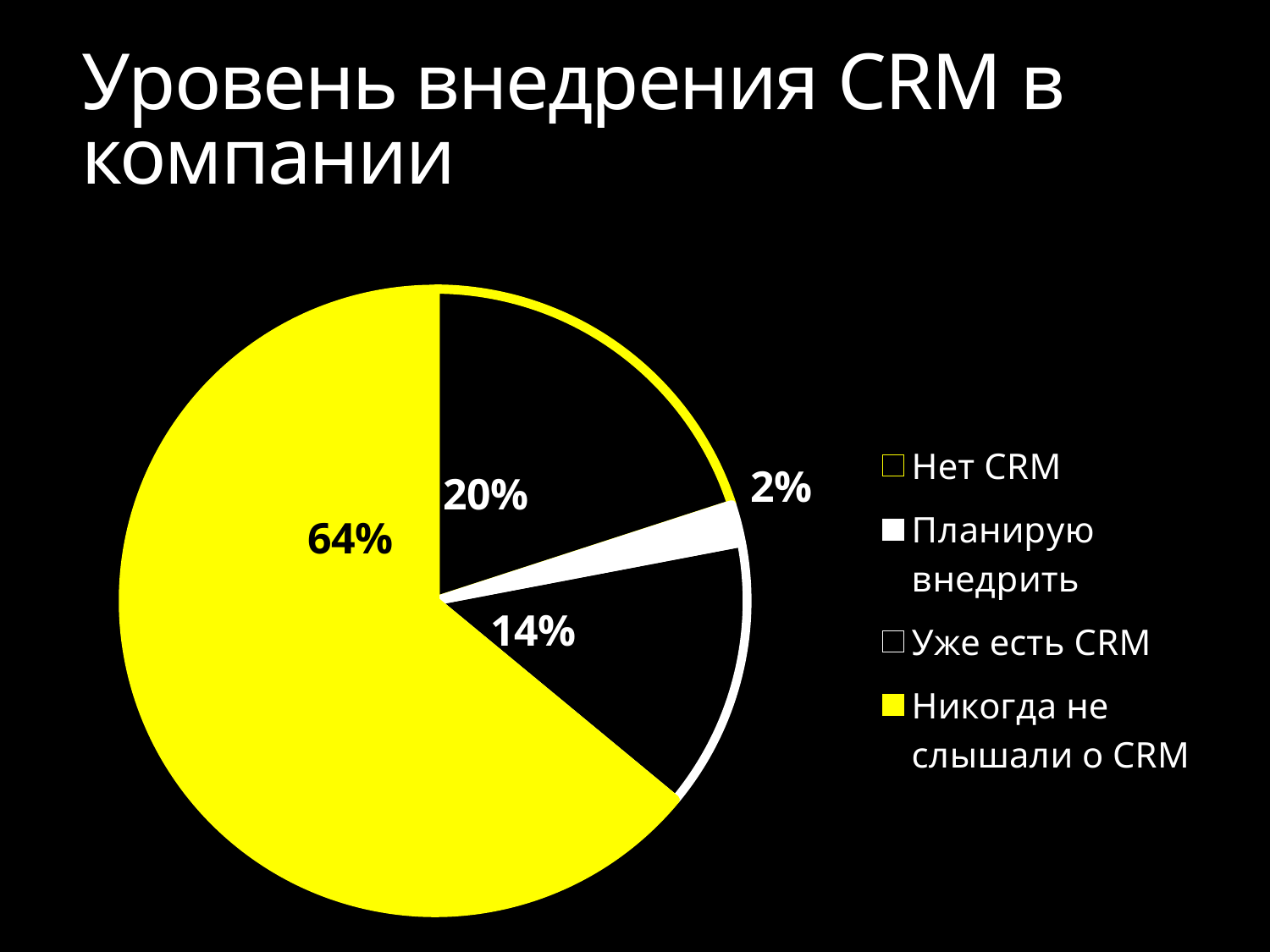
How many slices does the pie chart have? 4 What colour is the slice for 'Никогда не слышали о CRM'? yellow What share of the pie is labelled 'Никогда не слышали о CRM'? 64% What is the title of the chart on the slide? Уровень внедрения CRM в компании What share of the pie is labelled 'Нет CRM'? 20% Which category has the smallest slice of the pie? Планирую внедрить What kind of chart is shown on the slide? pie chart Which category has the largest slice of the pie? Никогда не слышали о CRM What share of the pie is labelled 'Планирую внедрить'? 2% What is the difference between the 'Никогда не слышали о CRM' share and the 'Нет CRM' share? 44% Which is larger: the 'Нет CRM' slice or the 'Уже есть CRM' slice? Нет CRM